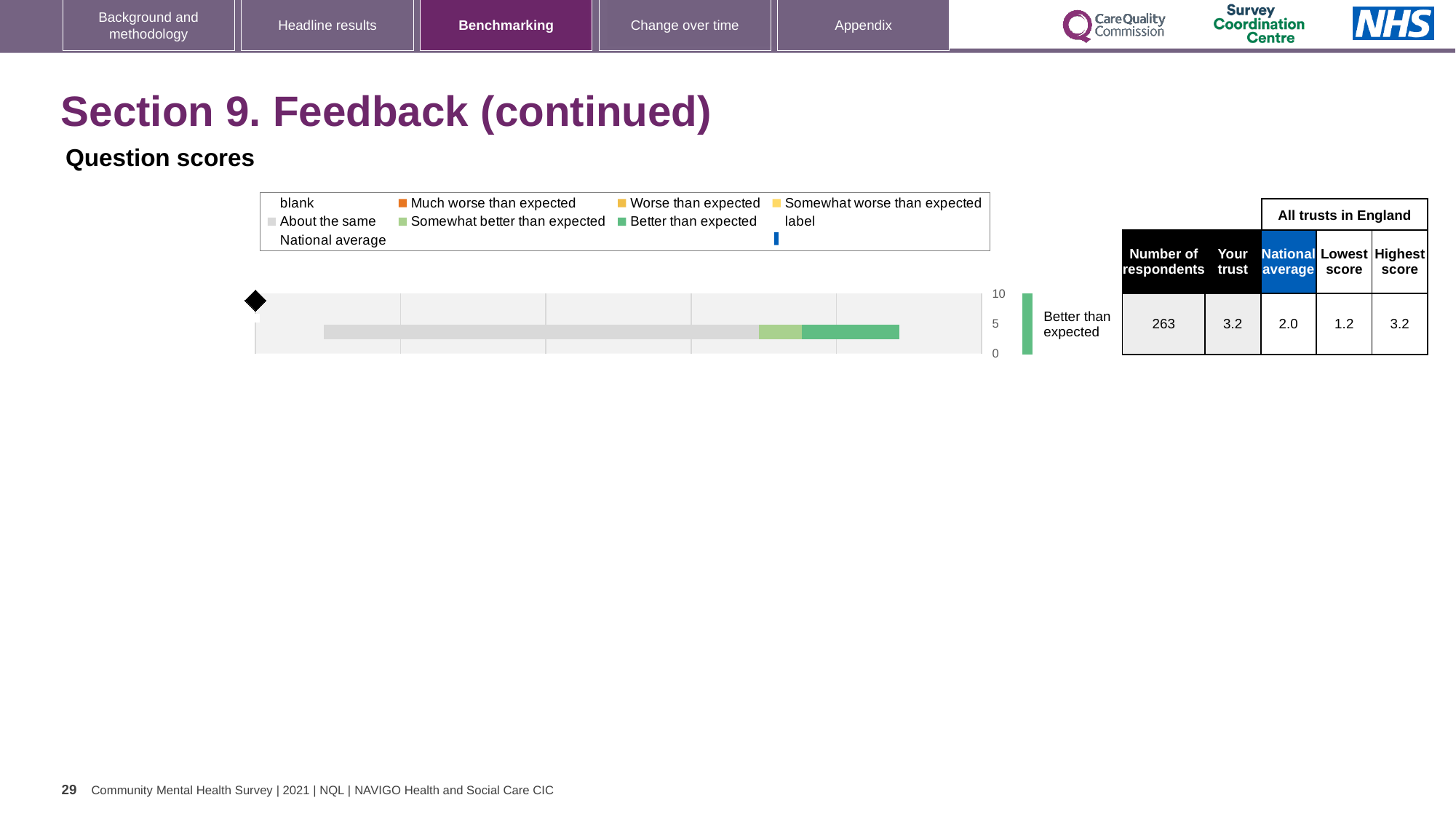
What is the difference between the 'Your trust' score and the national average for the 'Better than expected' row? 1.2 What is the national average score shown for the 'Better than expected' row? 2.0 Is the 'Your trust' score or the national average larger for the 'Better than expected' row? Your trust What is the highest tick value shown on the vertical axis of the chart? 10 What is the 'Your trust' score shown for the 'Better than expected' row? 3.2 Which legend entry is shown in light grey? About the same How many entries does the chart legend list? 9 What category label is shown to the right of the chart bar? Better than expected What kind of chart is shown on the slide? bar chart What is the number of respondents shown for the 'Better than expected' row? 263 Which legend entry is shown in dark green? Better than expected How many bars are plotted in the chart? 1